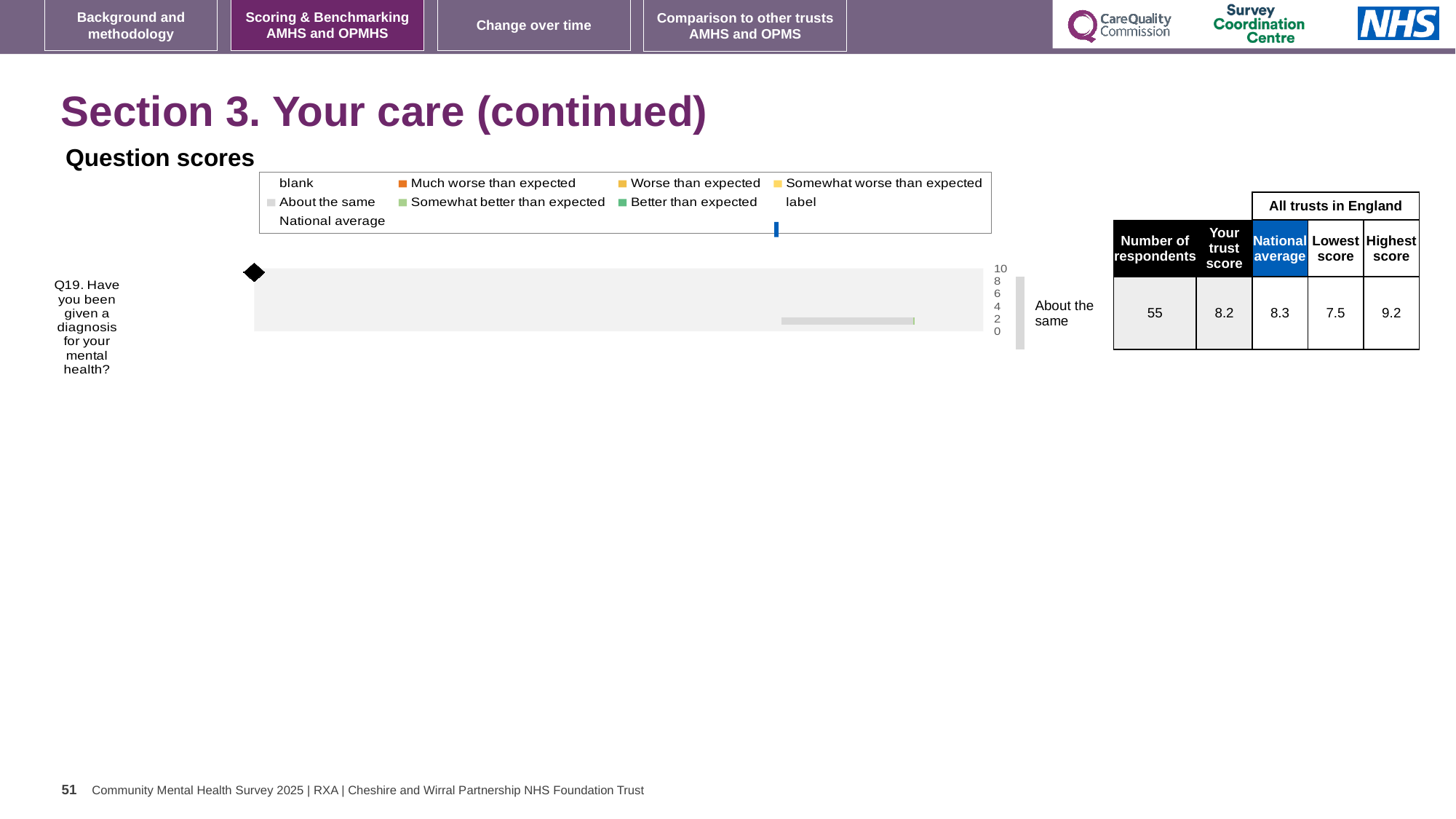
In the table beside the chart, what is the national average score for Q19? 8.3 In the table beside the chart, what is the trust's score for Q19? 8.2 What benchmark category label is shown to the right of the chart for Q19? About the same For Q19, what is the difference between the highest score and the lowest score among all trusts in England? 1.7 In the table beside the chart, what is the number of respondents for Q19? 55 Which question is plotted in the question scores chart? Q19. Have you been given a diagnosis for your mental health? For Q19, which is larger: the trust's score or the national average? National average What kind of chart is used to show the question scores on this slide? bar chart What is the highest tick value shown on the chart's score axis? 10 How many survey questions are plotted in the question scores chart? 1 In the table beside the chart, what is the lowest score among all trusts in England for Q19? 7.5 In the table beside the chart, what is the highest score among all trusts in England for Q19? 9.2